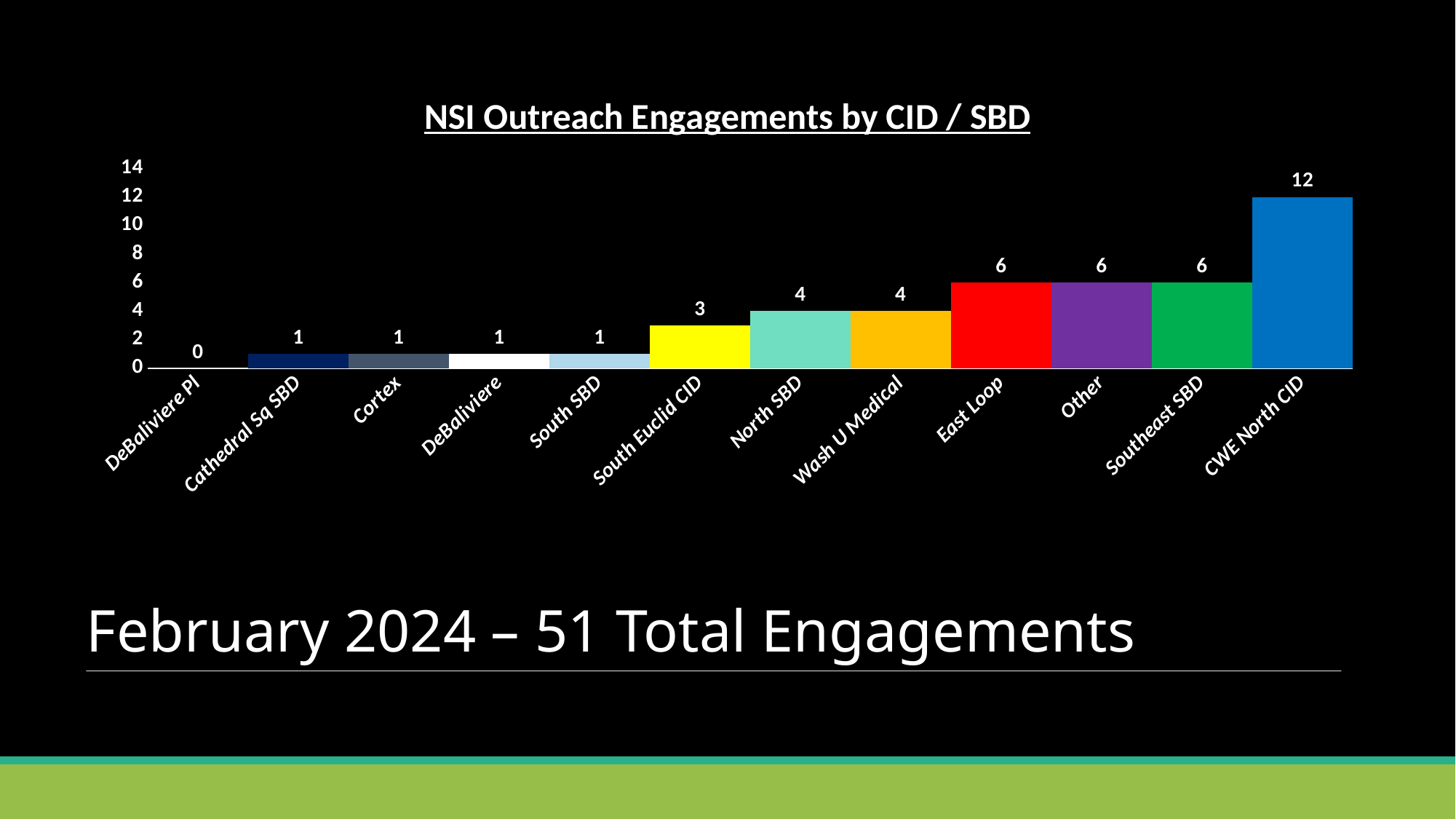
What is the value for CWE North CID? 12 Which category has the lowest value? DeBaliviere Pl What is the difference between the values for CWE North CID and East Loop? 6 What is the title of the chart? NSI Outreach Engagements by CID / SBD How many categories are shown on the x axis? 12 Do the values generally rise or fall from left to right along the x axis? rise What kind of chart is this? bar chart What is the value for Wash U Medical? 4 What is the value for DeBaliviere Pl? 0 Which category has the highest value? CWE North CID What is the value for South Euclid CID? 3 Which is larger, the value for North SBD or the value for Cortex? North SBD